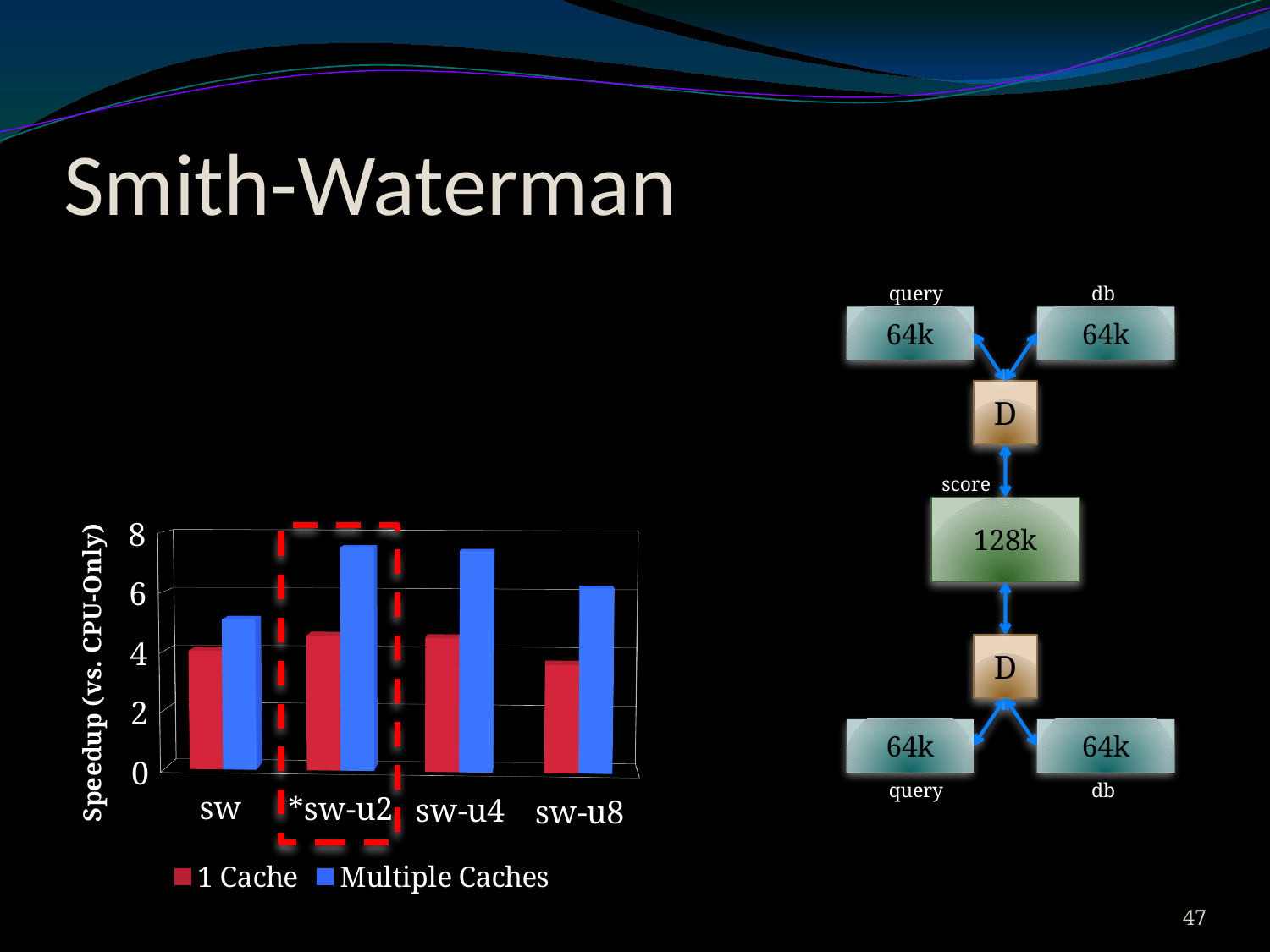
Is the Multiple Caches value for *sw-u2 greater or less than 6? greater Is the Multiple Caches value for sw greater or less than 4? greater For sw-u8, which series has the larger speedup, 1 Cache or Multiple Caches? Multiple Caches Which category is highlighted with a red dashed box in the chart? *sw-u2 How many series does the chart's legend list? 2 What is the label of the chart's y axis? Speedup (vs. CPU-Only) Is the 1 Cache value for sw-u8 greater or less than 4? less How many categories are shown on the x axis of the chart? 4 Which has the larger Multiple Caches speedup, sw or *sw-u2? *sw-u2 Which category has the lowest Multiple Caches speedup? sw Which category has the lowest 1 Cache speedup? sw-u8 What kind of chart is shown on the slide? bar chart